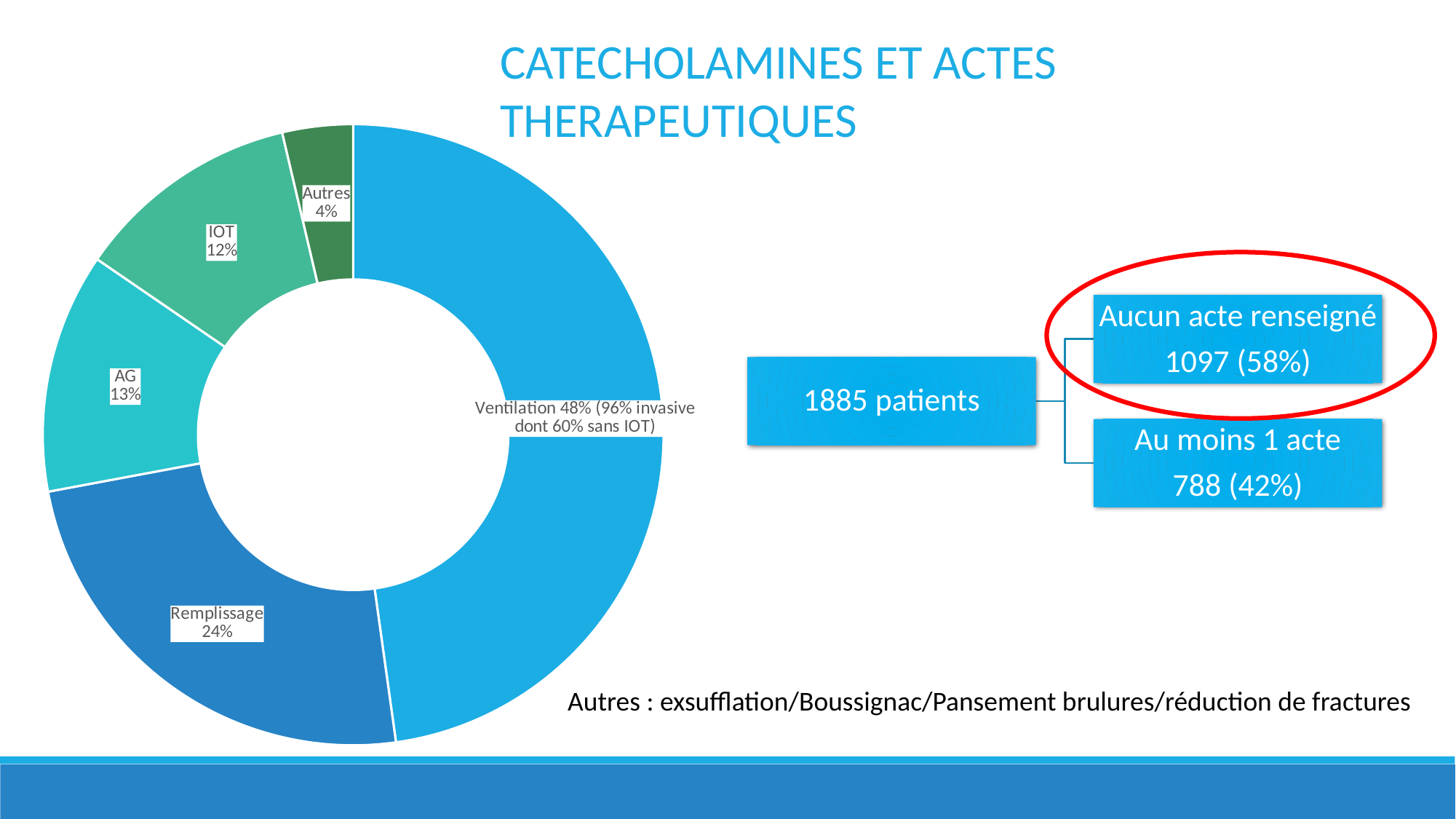
What percentage is shown for IOT in the pie chart? 12% Which category has the smallest slice in the pie chart? Autres What is the title of the slide containing the chart? CATECHOLAMINES ET ACTES THERAPEUTIQUES What share of the pie chart does Ventilation represent? 48% Which category has the largest slice in the pie chart? Ventilation What is the difference in percentage points between Ventilation and Remplissage? 24 What percentage is shown for AG in the pie chart? 13% What kind of chart is shown on the slide? Pie chart (doughnut) What percentage is shown for Autres in the pie chart? 4% Which is larger, the AG slice or the IOT slice? AG What percentage is shown for Remplissage in the pie chart? 24% How many categories are shown in the pie chart? 5